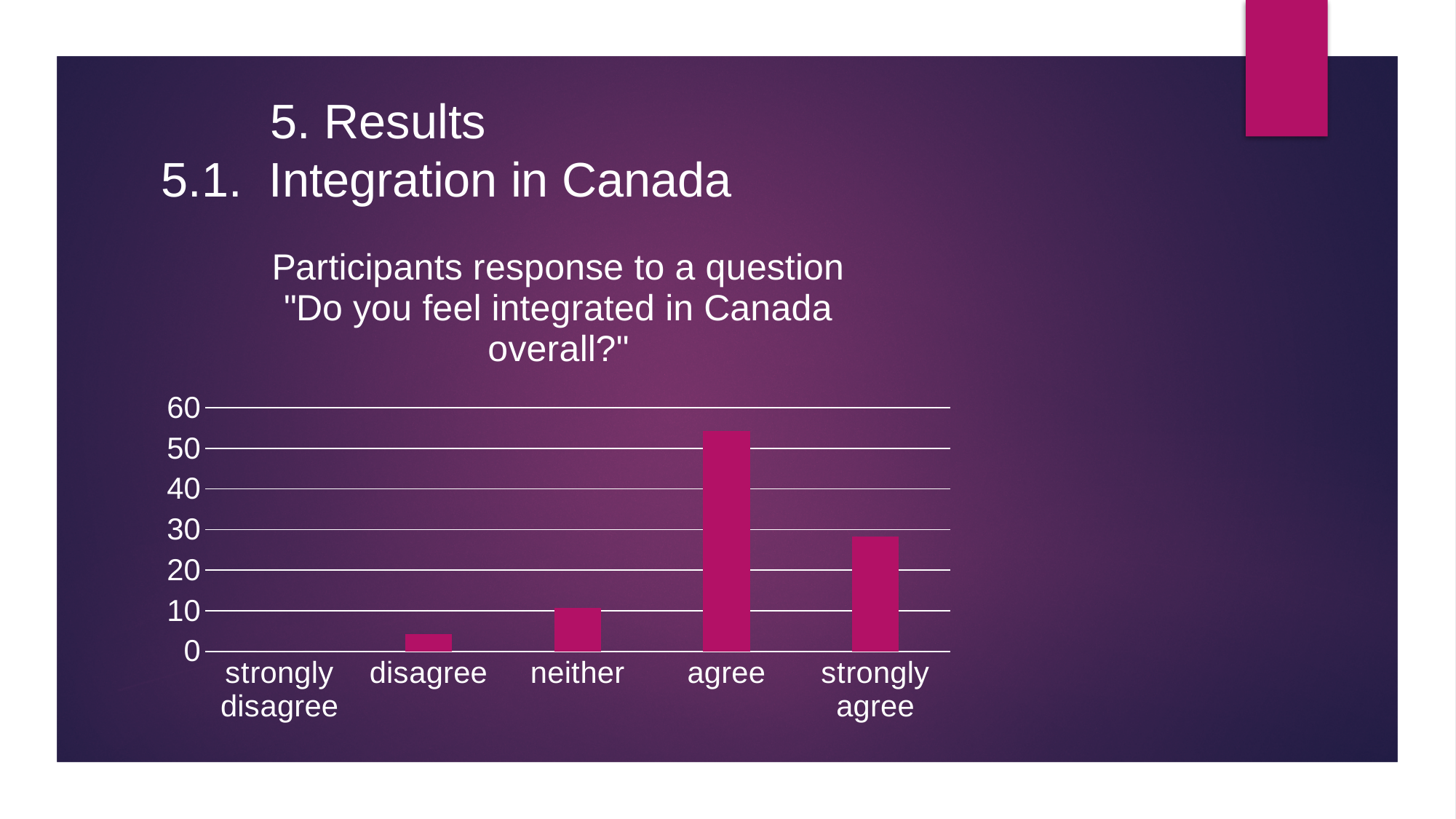
Which is larger, the value for agree or the value for strongly agree? agree Which is larger, the value for neither or the value for disagree? neither Which response category has the highest value? agree Which response category has the lowest value? strongly disagree Is the value for disagree greater or less than 10? less How many response categories are shown on the x axis? 5 What is the highest value shown on the y axis? 60 What colour are the bars in the chart? magenta Do the values rise or fall going from strongly disagree to agree along the x axis? rise Is the value for strongly agree greater or less than 20? greater Is the value for agree greater or less than 50? greater What kind of chart is shown on the slide? bar chart